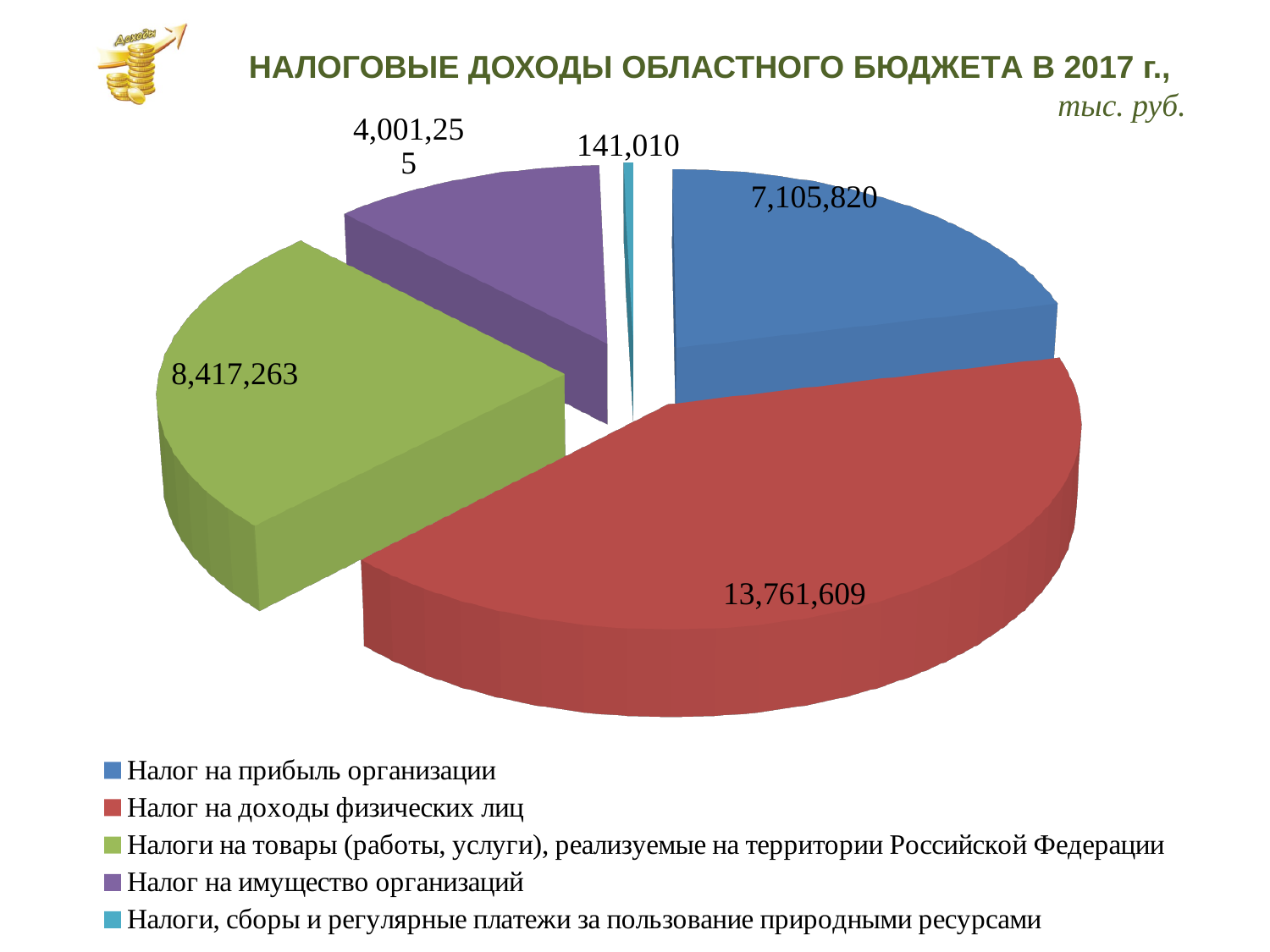
What unit is stated for the values in the chart title? тыс. руб. Which category has the largest value? Налог на доходы физических лиц How many categories does the pie chart show? 5 What is the value for Налог на прибыль организации? 7,105,820 Which category has the smallest value? Налоги, сборы и регулярные платежи за пользование природными ресурсами What is the value for Налоги на товары (работы, услуги), реализуемые на территории Российской Федерации? 8,417,263 What is the value for Налог на имущество организаций? 4,001,255 What type of chart is shown on the slide? Pie chart What is the value for Налог на доходы физических лиц? 13,761,609 What is the difference between the values for Налог на доходы физических лиц and Налог на прибыль организации? 6,655,789 What is the value for Налоги, сборы и регулярные платежи за пользование природными ресурсами? 141,010 Which is larger: Налоги на товары (работы, услуги), реализуемые на территории Российской Федерации or Налог на имущество организаций? Налоги на товары (работы, услуги), реализуемые на территории Российской Федерации